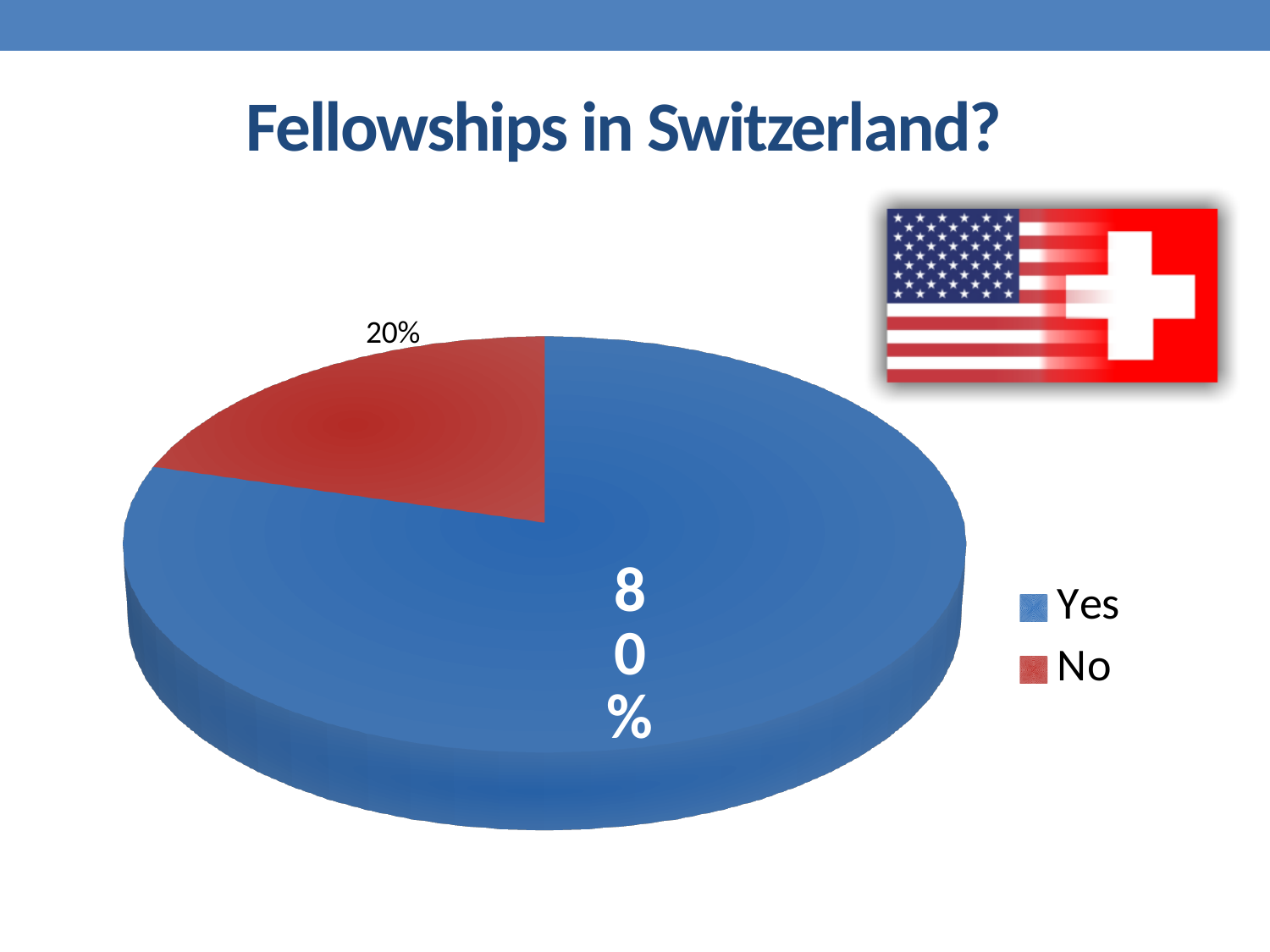
Which is larger, the Yes slice or the No slice? Yes How many slices does the pie chart have? 2 What share of the pie does the No slice represent? 20% Which slice is the largest in the pie chart? Yes Which slice is the smallest in the pie chart? No What kind of chart is shown on the slide? pie chart What colour is the No slice in the pie chart? red What is the title of the slide containing the pie chart? Fellowships in Switzerland? What is the difference in percentage points between the Yes and No slices? 60 percentage points What share of the pie does the Yes slice represent? 80% How many entries does the legend list? 2